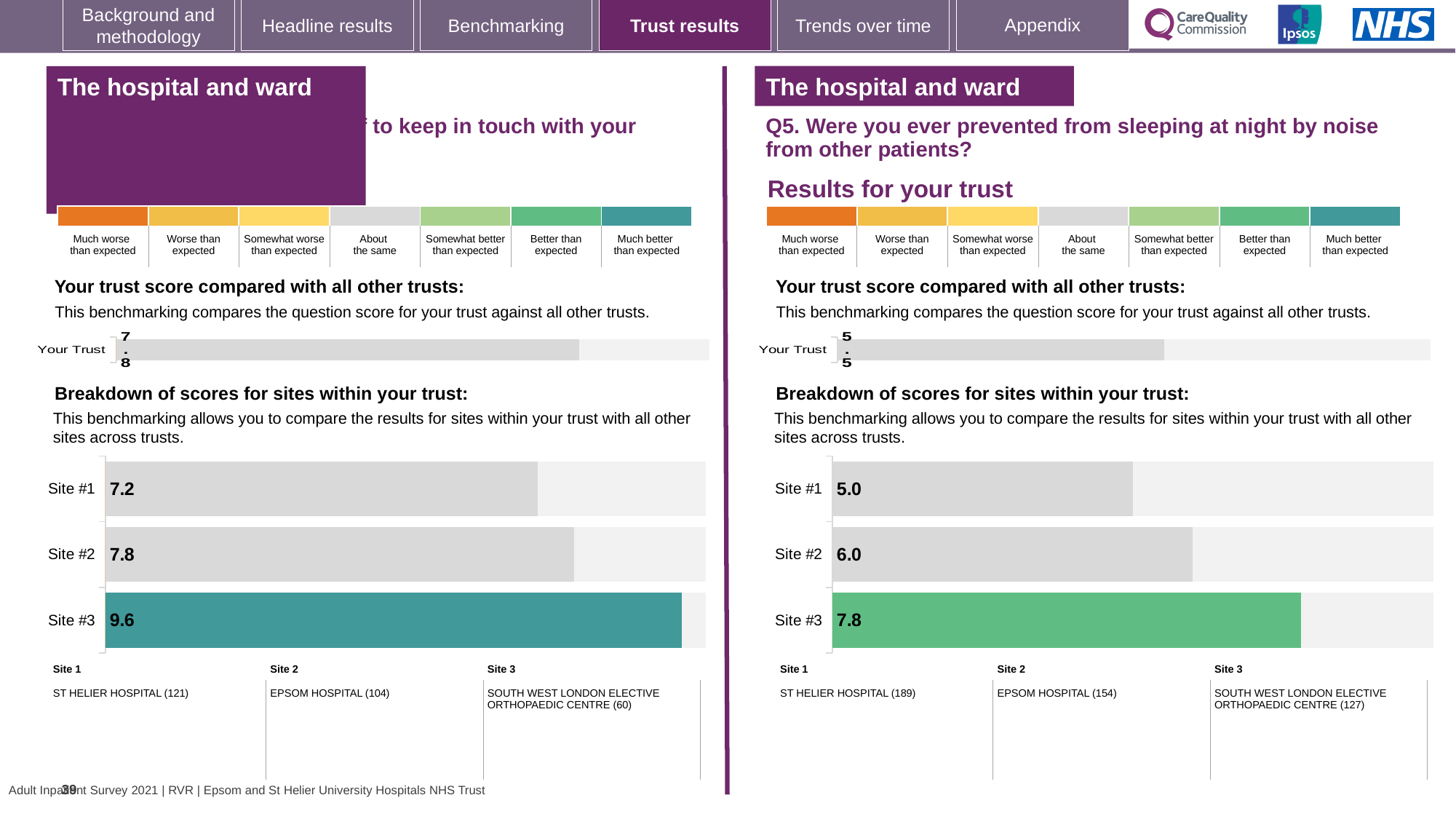
On the right-hand slide (Q5), which is larger: the score for Site #1 or Site #2? Site #2 What kind of chart is used for the breakdown of scores for sites on the left-hand slide? Bar chart On the right-hand slide (Q5, noise from other patients), what is the score for Site #1 in the breakdown of scores for sites? 5.0 On the left-hand slide, what is the score for Site #2 in the breakdown of scores for sites? 7.8 On the left-hand slide, what is the difference between the scores for Site #3 and Site #2? 1.8 On the right-hand slide (Q5), which site has the highest score in the site breakdown chart? Site #3 On the right-hand slide (Q5), what is the score for Site #3 in the site breakdown chart? 7.8 On the right-hand slide (Q5), what is the 'Your Trust' score shown in the trust comparison chart? 5.5 How many sites are shown in the site breakdown chart on the right-hand slide (Q5)? 3 On the right-hand slide (Q5), what is the difference between the scores for Site #3 and Site #1? 2.8 On the left-hand slide, which site has the lowest score in the site breakdown chart? Site #1 On the left-hand slide, what is the score for Site #3 in the site breakdown chart? 9.6